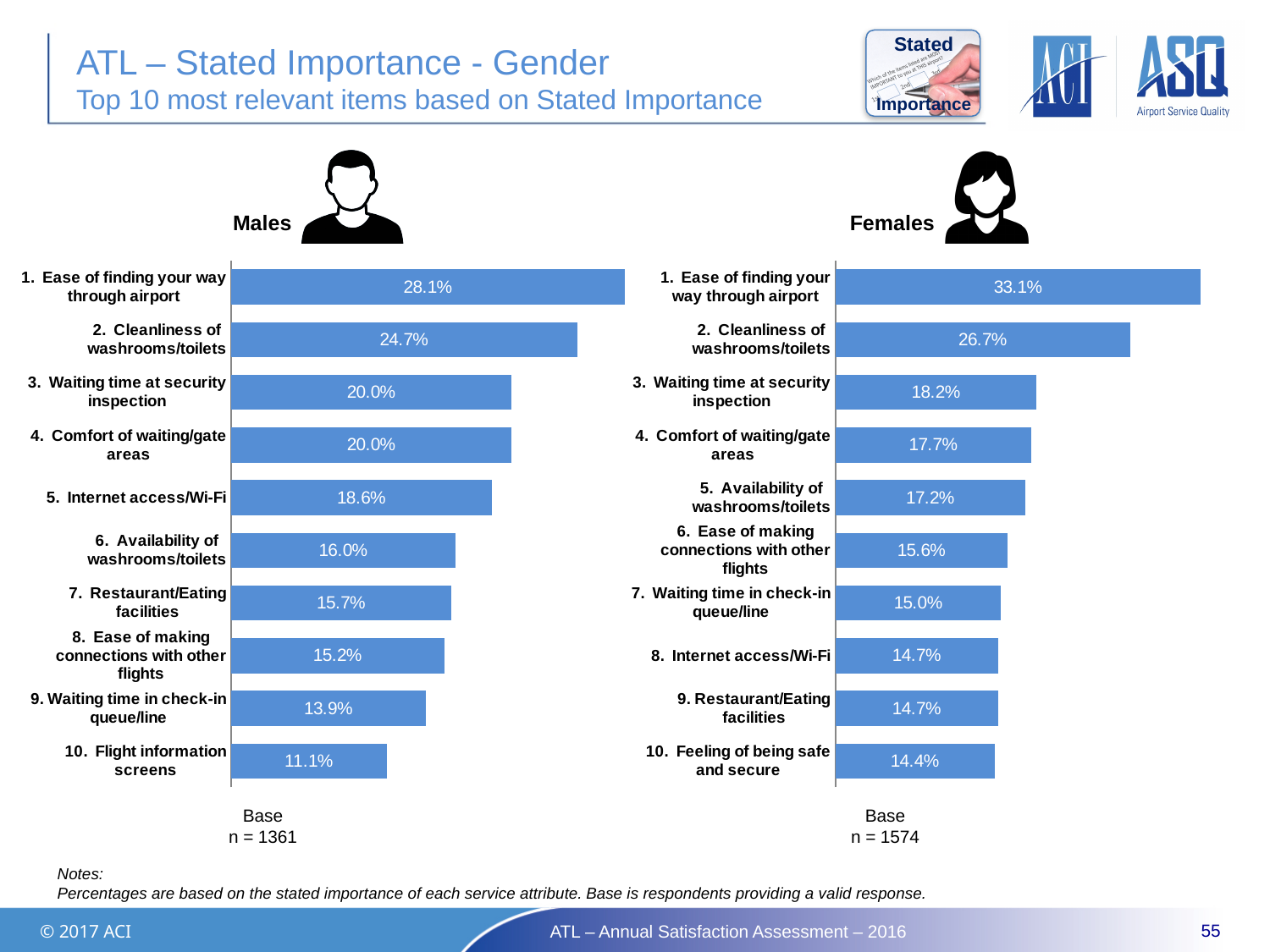
In the Females chart, which item has the highest value? Ease of finding your way through airport In the Females chart, what is the value for Feeling of being safe and secure? 14.4% In the Males chart, which item has the lowest value? Flight information screens In the Males chart, what is the value for Internet access/Wi-Fi? 18.6% What is the base (n) for the Females chart? n = 1574 In the Males chart, do the values rise or fall from the top item to the bottom item? Fall In the Males chart, what is the value for Ease of finding your way through airport? 28.1% Which is larger: the Males value for Waiting time at security inspection or the Females value for Waiting time at security inspection? Males What is the difference between the Females and Males values for Ease of finding your way through airport? 5.0% How many items are shown in the Males chart? 10 What kind of chart is used for the Females data? Bar chart In the Females chart, what is the value for Cleanliness of washrooms/toilets? 26.7%